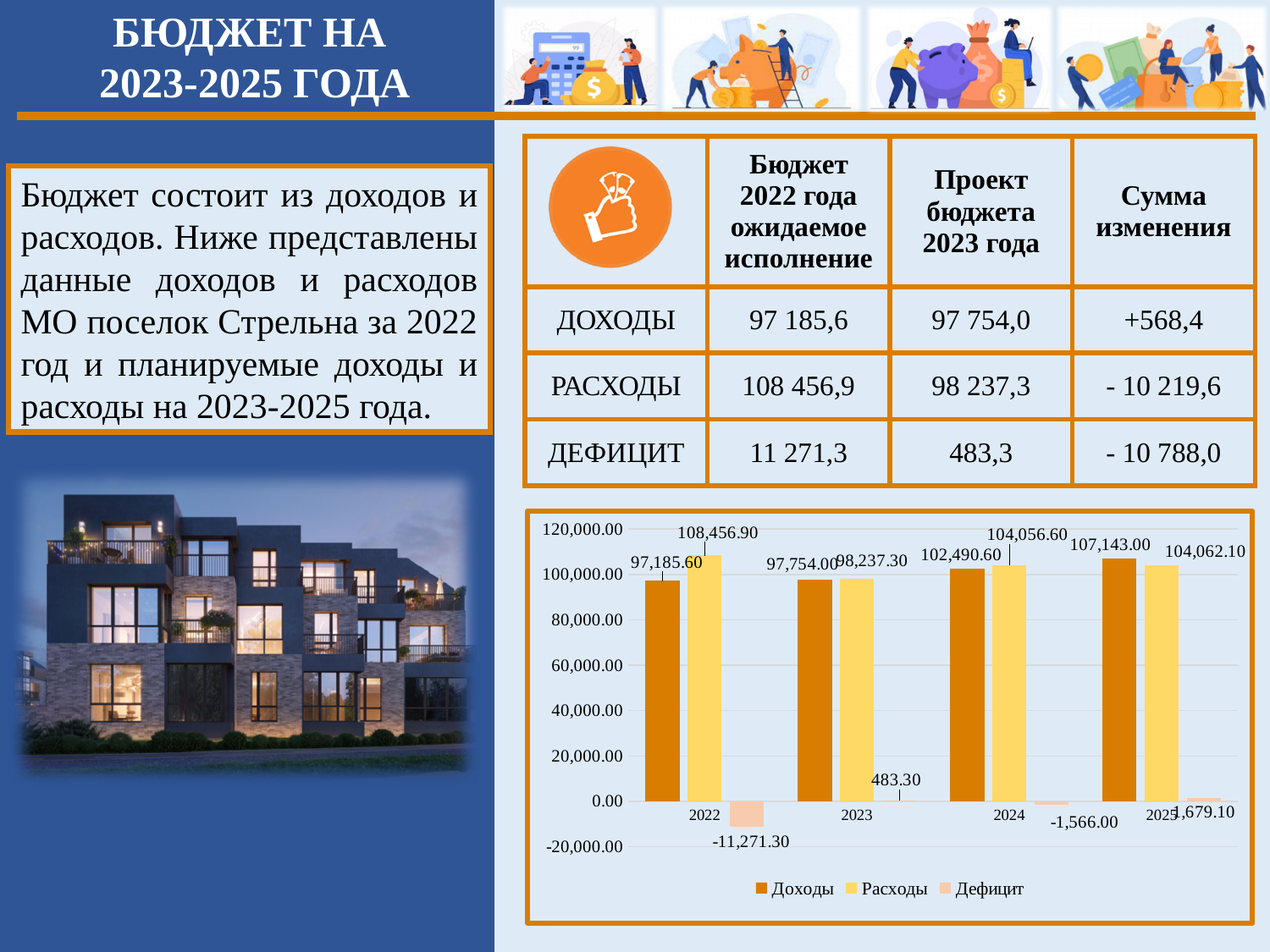
What is the value of Дефицит for 2022 in the chart? -11,271.30 Does Доходы rise or fall from 2022 to 2025 in the chart? rise How many years are shown on the x axis of the chart? 4 By how much does Доходы in 2025 exceed Доходы in 2022 in the chart? 9,957.40 What is the value of Расходы for 2024 in the chart? 104,056.60 How many series does the chart legend list? 3 Which is larger in 2025 in the chart, Доходы or Расходы? Доходы What is the value of Доходы for 2022 in the chart? 97,185.60 What is the value of Дефицит for 2023 in the chart? 483.30 What is the difference between Расходы and Доходы for 2022 in the chart? 11,271.30 In which year is Доходы highest in the chart? 2025 In which year is Расходы lowest in the chart? 2023